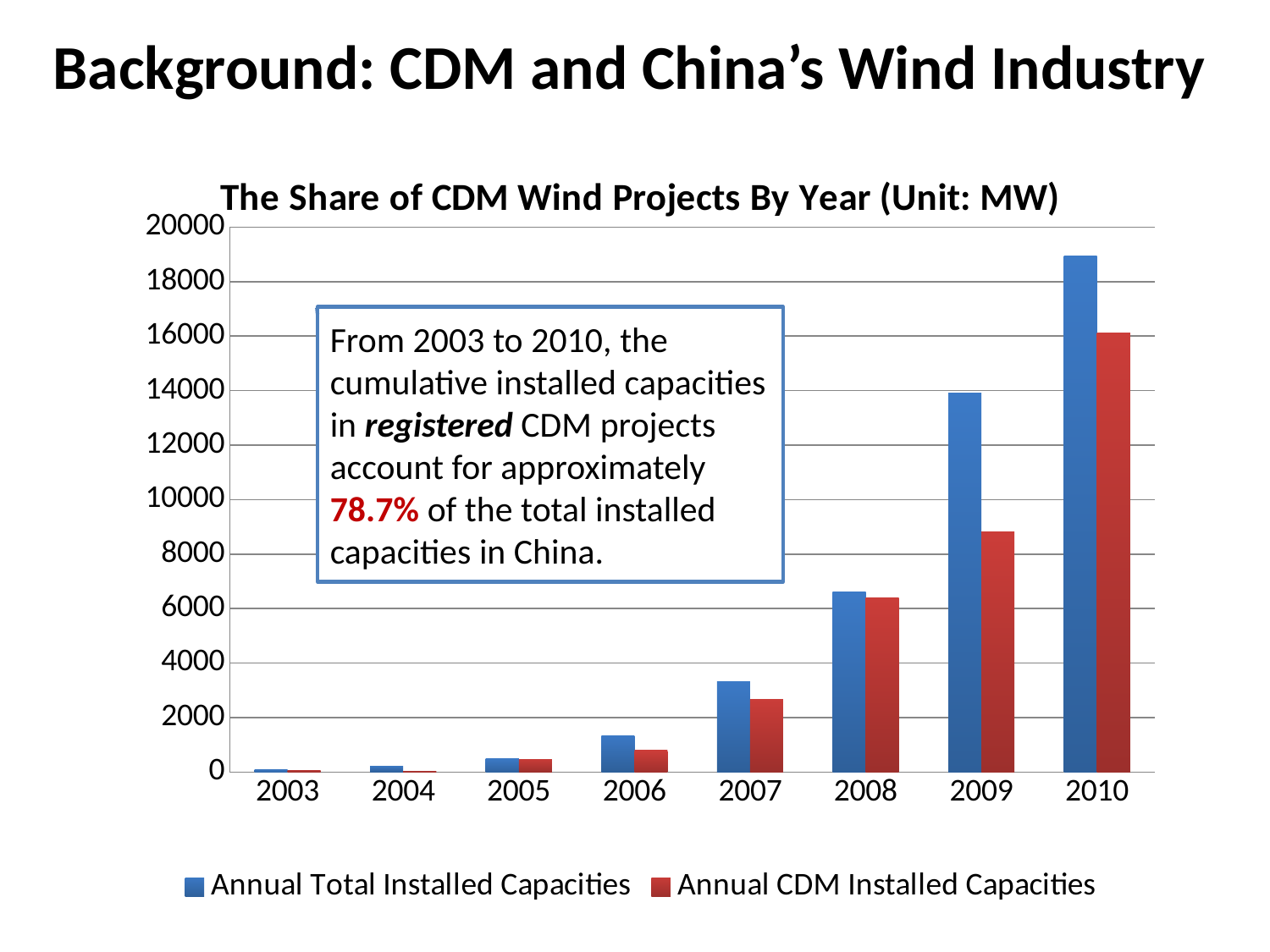
Which is larger in 2009: Annual Total Installed Capacities or Annual CDM Installed Capacities? Annual Total Installed Capacities Do the Annual Total Installed Capacities values rise or fall from 2003 to 2010? Rise How many series does the chart legend list? 2 Which year has the highest Annual CDM Installed Capacities? 2010 What kind of chart is shown on the slide? Bar chart Is the Annual Total Installed Capacities value for 2010 greater or less than 18000? greater Is the Annual CDM Installed Capacities value for 2009 greater or less than 10000? less Is the Annual Total Installed Capacities value for 2007 greater or less than 4000? less How many years are shown on the x axis of the chart? 8 Which year has the lowest Annual Total Installed Capacities? 2003 Which year has the highest Annual Total Installed Capacities? 2010 What is the title of the chart? The Share of CDM Wind Projects By Year (Unit: MW)